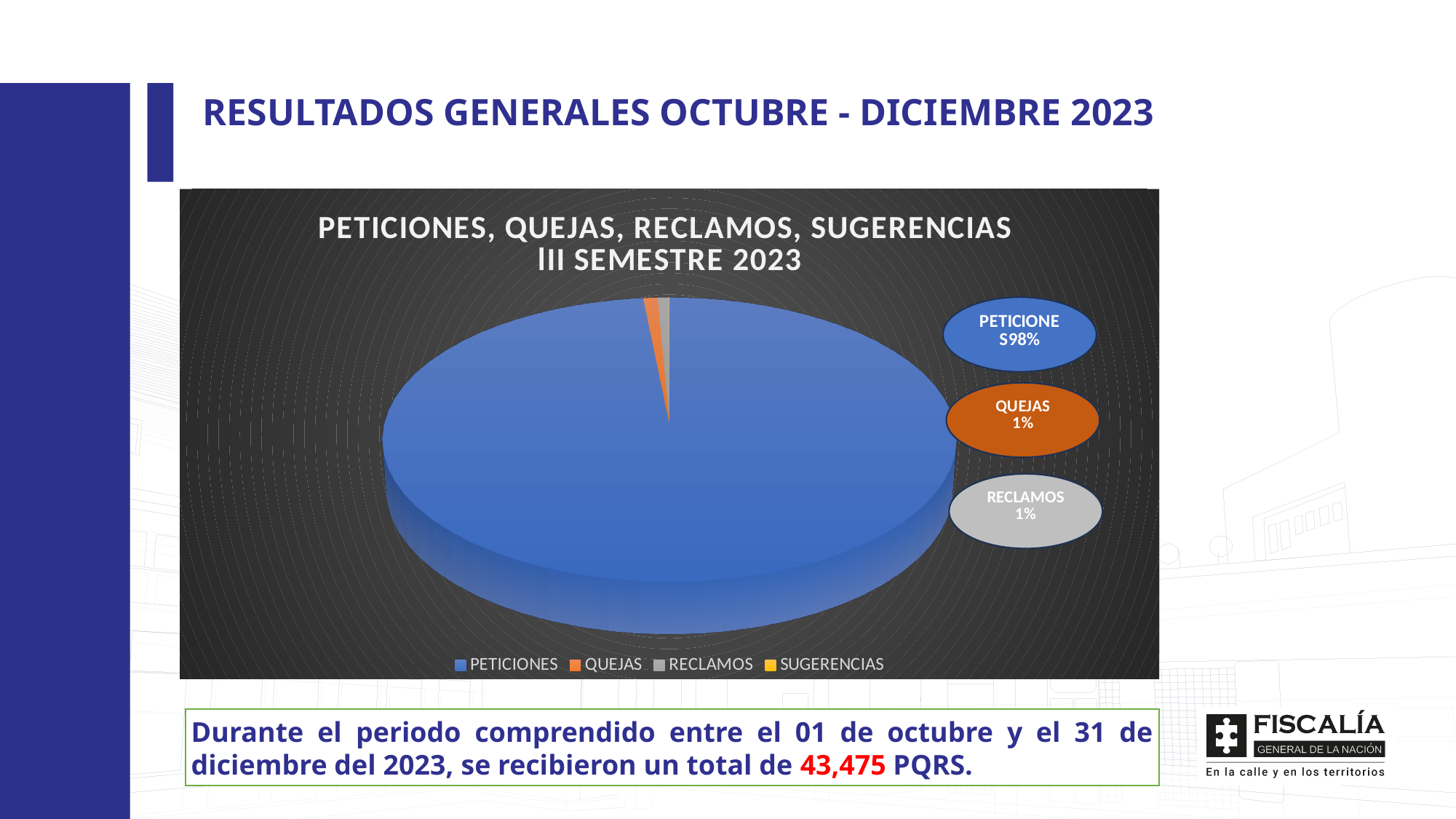
Which category has the largest share of the pie? PETICIONES What percentage of the pie does RECLAMOS represent? 1% How many categories does the legend list? 4 Is the share for PETICIONES greater or less than 50%? greater What percentage of the pie does QUEJAS represent? 1% Which is larger, the share for PETICIONES or the share for QUEJAS? PETICIONES What is the difference in percentage points between the PETICIONES share and the RECLAMOS share? 97 What percentage of the pie does PETICIONES represent? 98% What is the title of the chart? PETICIONES, QUEJAS, RECLAMOS, SUGERENCIAS III SEMESTRE 2023 What kind of chart is shown on the slide? Pie chart What colour represents PETICIONES in the chart? Blue